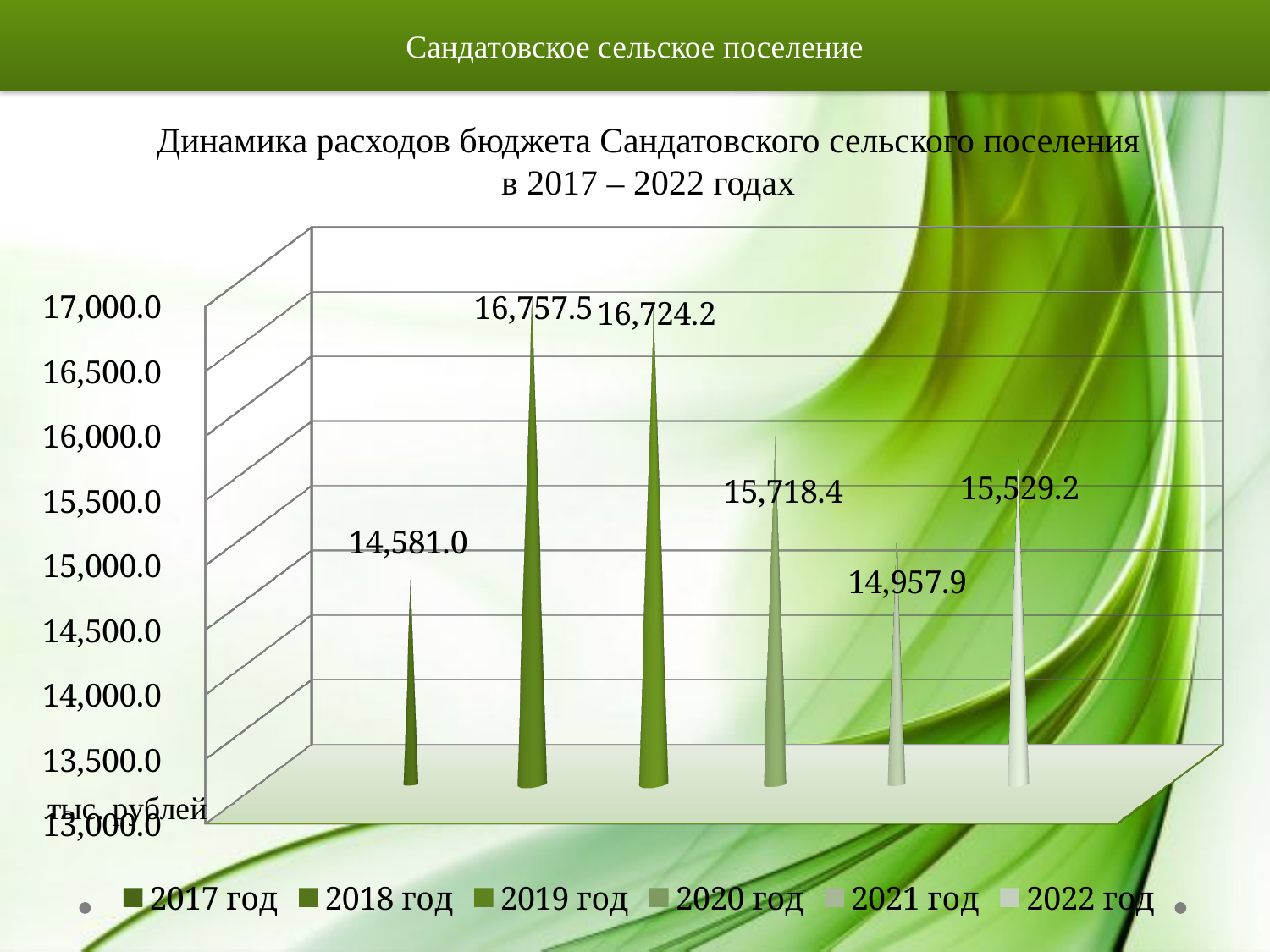
What is the value for 2022 год? 15,529.2 What kind of chart is shown on the slide? bar chart Which year has the lowest value? 2017 год How many series does the legend list? 6 What is the value for 2021 год? 14,957.9 What is the difference between the values for 2018 год and 2019 год? 33.3 What is the difference between the values for 2020 год and 2021 год? 760.5 Which year has the highest value? 2018 год What is the value for 2018 год? 16,757.5 Which is larger, the value for 2020 год or the value for 2022 год? 2020 год Do the values rise or fall from 2019 год to 2021 год? fall What is the value for 2017 год? 14,581.0